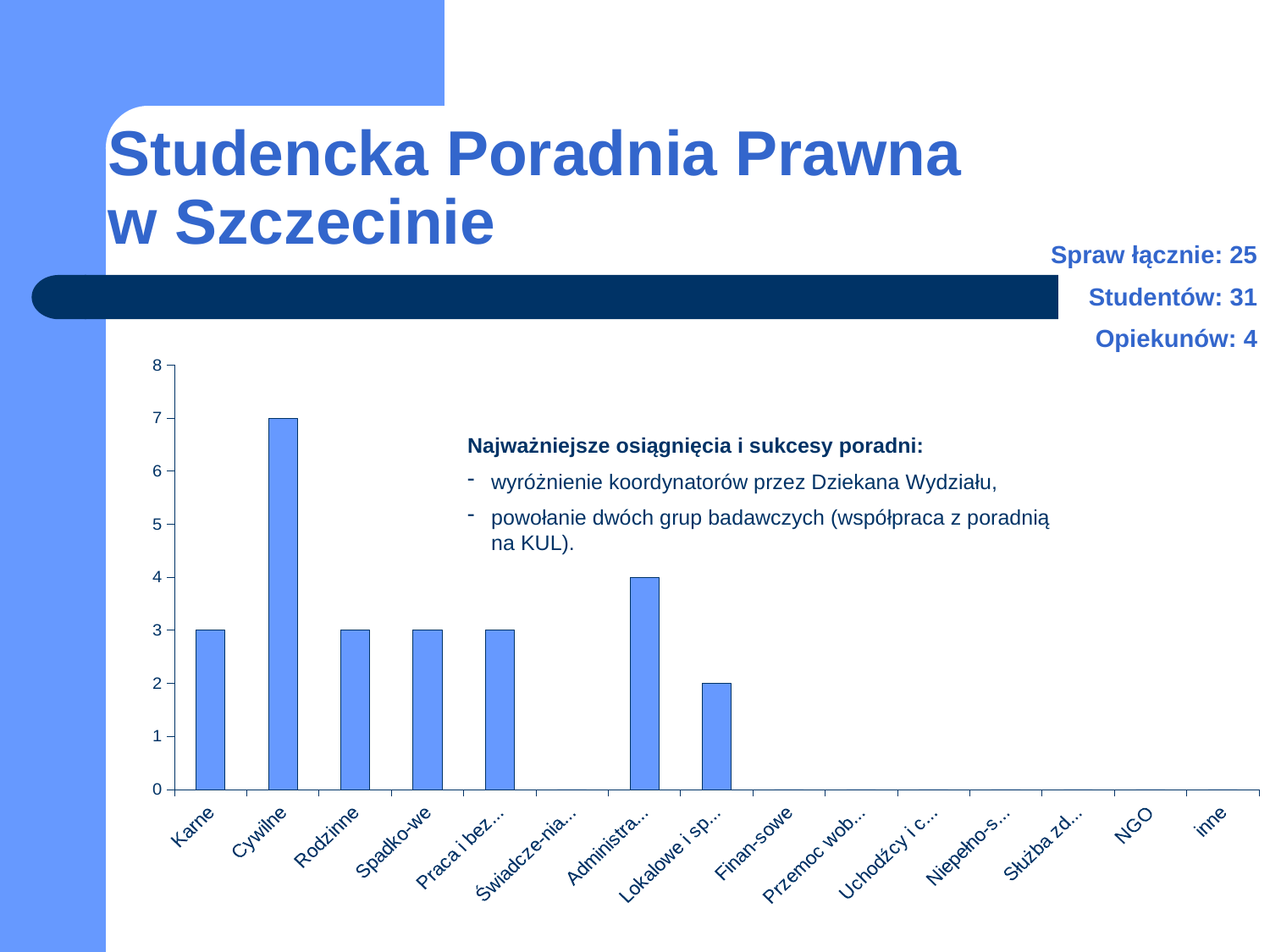
Which is larger, the value for Administra... or the value for Lokalowe i sp...? Administra... How many categories are shown on the x axis? 15 What kind of chart is shown on the slide? bar chart What is the value for Karne? 3 What is the value for Lokalowe i sp...? 2 Which category has the highest value? Cywilne Is the value for Cywilne greater or less than 5? greater What is the value for Cywilne? 7 What is the value for Administra...? 4 What is the difference between the values for Cywilne and Administra...? 3 What is the value for NGO? 0 What is the highest value shown on the y axis? 8